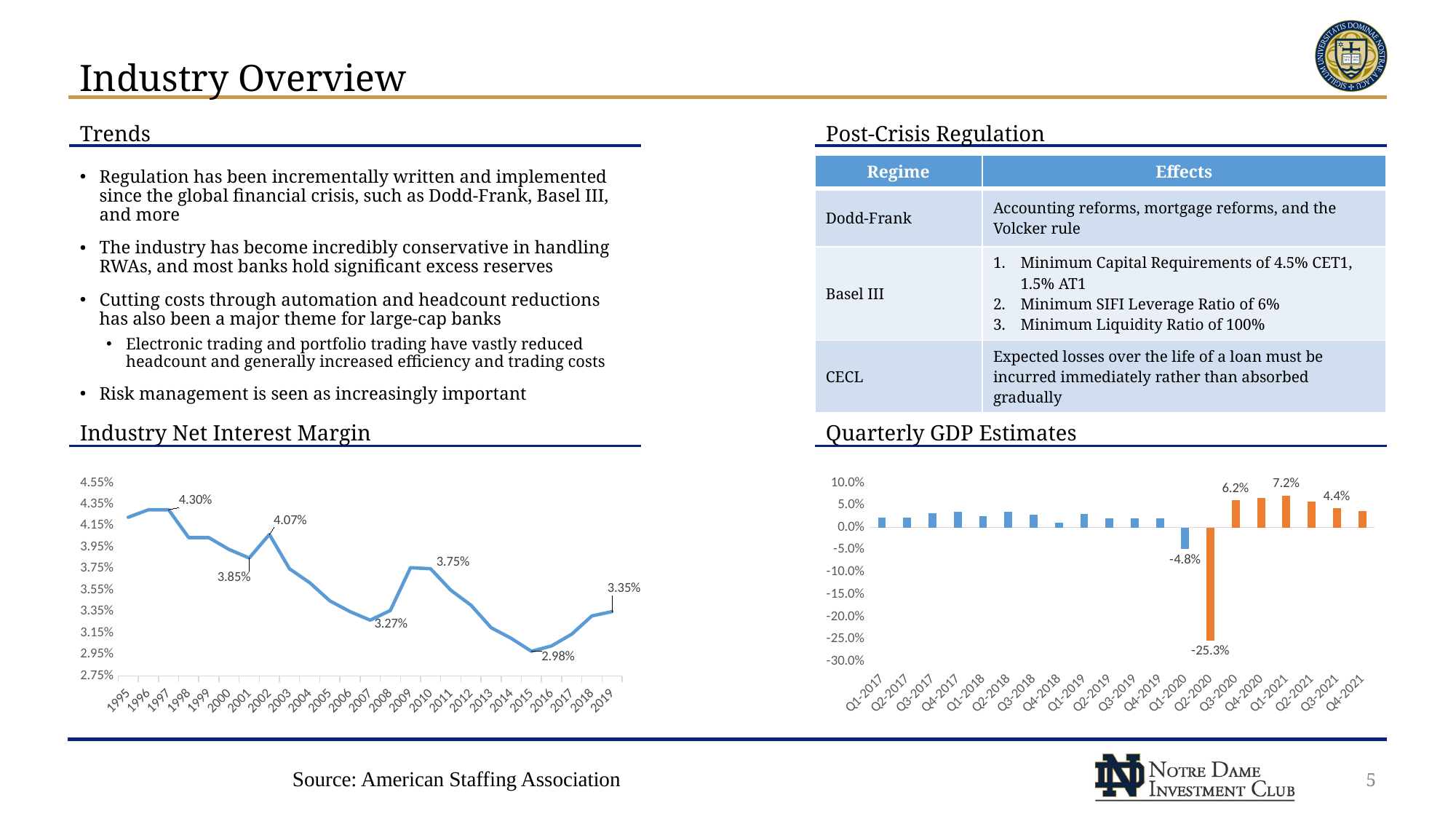
How many quarters are shown on the Quarterly GDP Estimates chart? 20 On the Industry Net Interest Margin chart, what is the value for 2002? 4.07% On the Industry Net Interest Margin chart, what is the value for 2015? 2.98% On the Industry Net Interest Margin chart, which year has the lowest net interest margin? 2015 On the Quarterly GDP Estimates chart, what is the difference between the Q1-2021 value and the Q3-2020 value? 1.0 percentage point On the Quarterly GDP Estimates chart, is the value for Q1-2017 greater or less than 5.0%? less What kind of chart is the Industry Net Interest Margin chart? Line chart On the Industry Net Interest Margin chart, what is the value for 2019? 3.35% On the Quarterly GDP Estimates chart, what is the value for Q2-2020? -25.3% On the Quarterly GDP Estimates chart, which quarter has the highest value? Q1-2021 On the Industry Net Interest Margin chart, what is the difference between the 1997 value and the 2015 value? 1.32 percentage points On the Industry Net Interest Margin chart, which is larger, the value for 2007 or the value for 2015? 2007